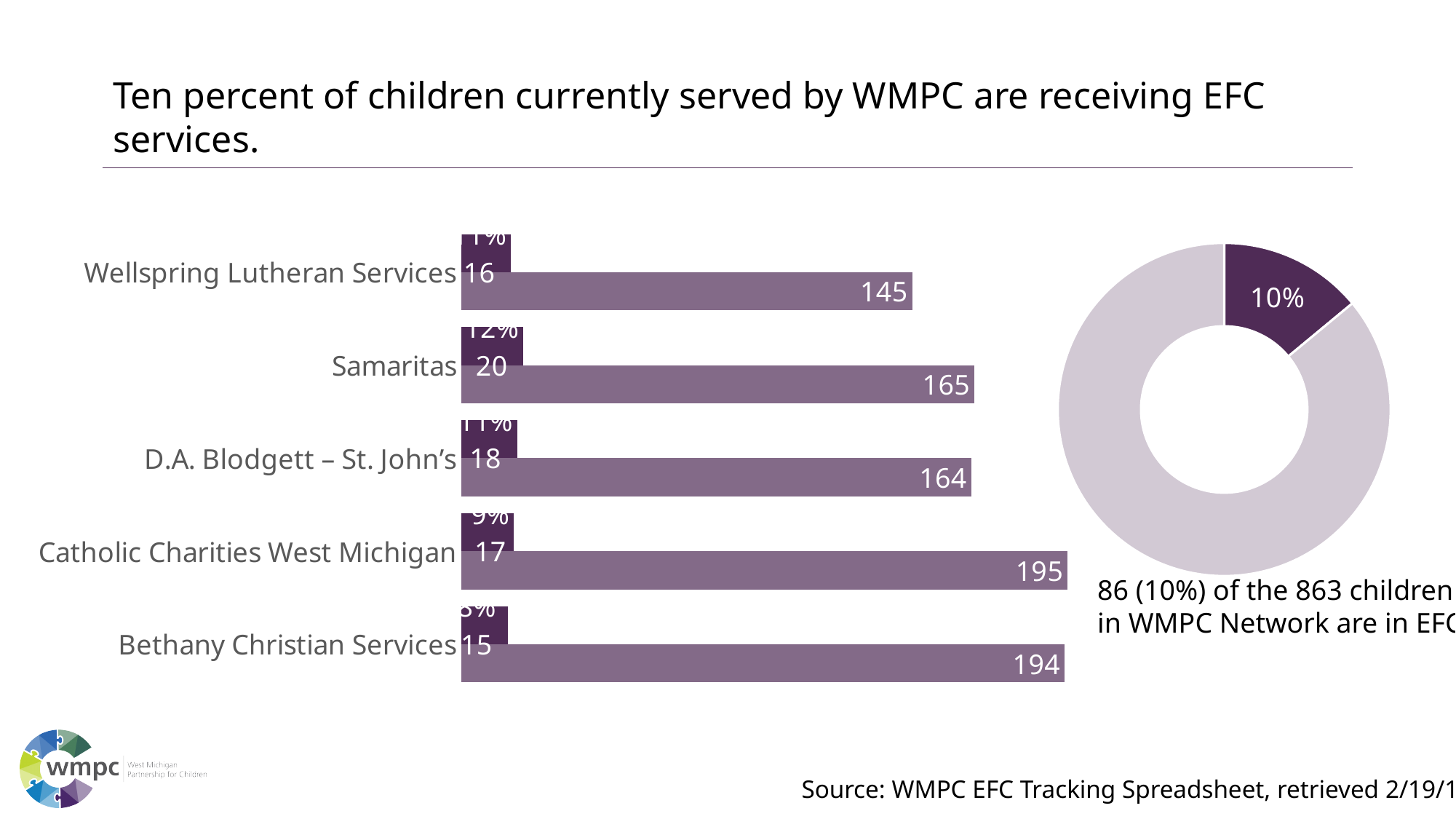
In the bar chart, which organization has the lowest value for the longer (lighter) bar series? Wellspring Lutheran Services In the bar chart, which organization has the highest value for the shorter (darker) bar series? Samaritas In the donut chart on the right, what share is shown for the dark purple slice? 10% In the bar chart, which has a larger longer (lighter) bar value: D.A. Blodgett – St. John's or Wellspring Lutheran Services? D.A. Blodgett – St. John's How many organizations are shown in the bar chart? 5 According to the text beside the donut chart, how many of the 863 children in the WMPC Network are in EFC? 86 In the bar chart, what is the difference between the longer (lighter) bar values for Samaritas and Wellspring Lutheran Services? 20 In the bar chart, what is the value of the longer (lighter) bar for Wellspring Lutheran Services? 145 In the bar chart, what is the value of the longer (lighter) bar for Catholic Charities West Michigan? 195 In the bar chart, what is the value of the shorter (darker) bar for Samaritas? 20 In the bar chart, what is the value of the shorter (darker) bar for Bethany Christian Services? 15 What kind of chart is shown on the left side of the slide? Bar chart